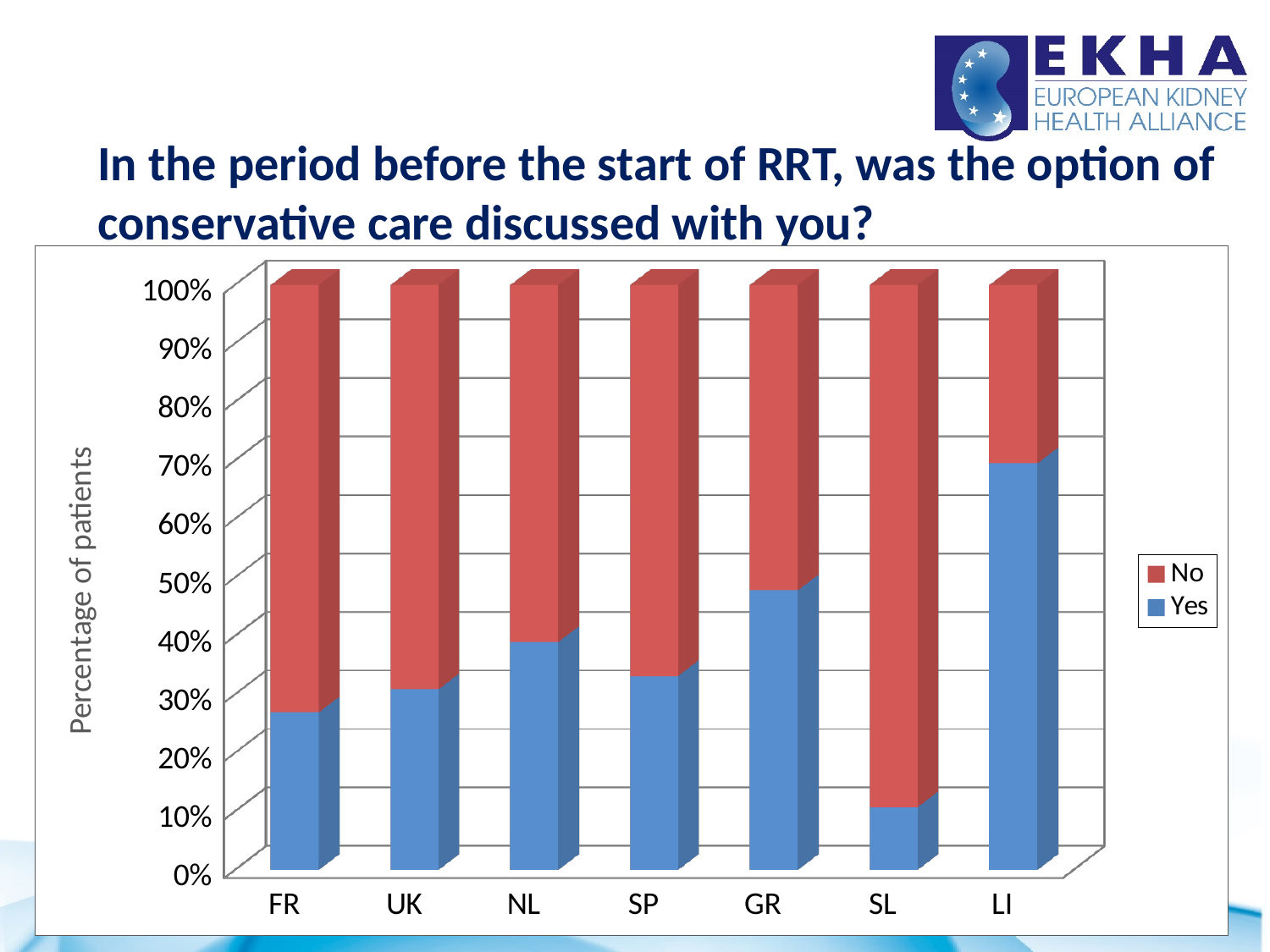
Which country has the highest share of patients answering Yes? LI How many countries are shown on the x axis of the chart? 7 Is the Yes share for GR greater or less than 40%? greater Is the Yes share for LI greater or less than 60%? greater Which country has the lowest share of patients answering Yes? SL What is the total height of each stacked bar in the chart? 100% Is the Yes share for SL greater or less than 20%? less Which country has a larger Yes share, GR or FR? GR How many series does the chart's legend list? 2 What is the label on the vertical axis of the chart? Percentage of patients What kind of chart is shown on the slide? Stacked bar chart